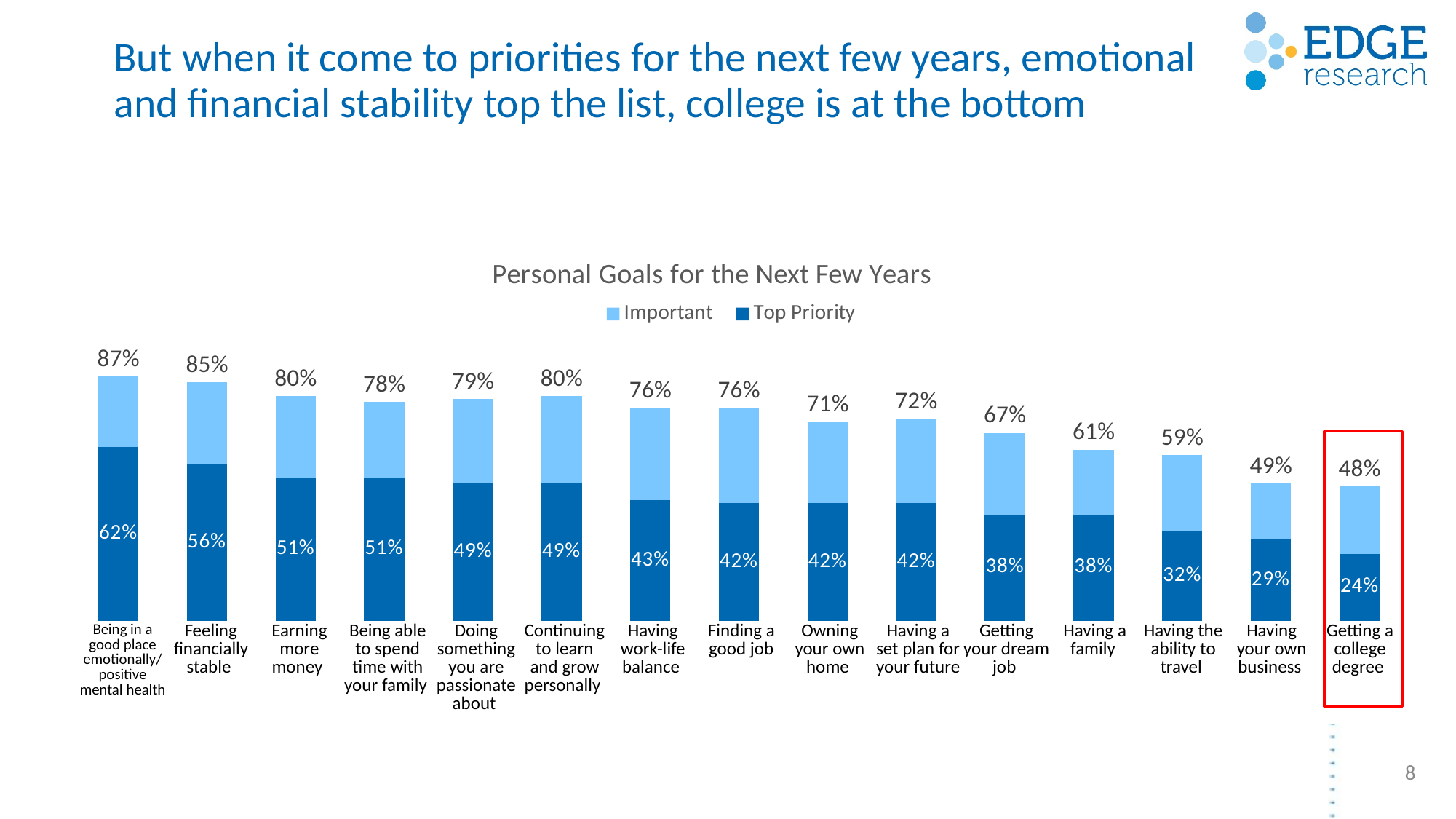
How many series does the legend list? 2 What is the Top Priority value for 'Getting a college degree'? 24% Do the total values generally rise or fall moving from left to right along the x axis? fall What is the Top Priority value for 'Feeling financially stable'? 56% Which category has the highest Top Priority value? Being in a good place emotionally/positive mental health What is the title of the chart? Personal Goals for the Next Few Years What is the total value shown above the bar for 'Having work-life balance'? 76% Which category has the lowest total value? Getting a college degree What type of chart is shown on the slide? bar chart How many categories are shown on the x axis of the chart? 15 What is the difference between the Top Priority values for 'Earning more money' and 'Having the ability to travel'? 19% Which has a larger Top Priority value, 'Having a family' or 'Having your own business'? Having a family